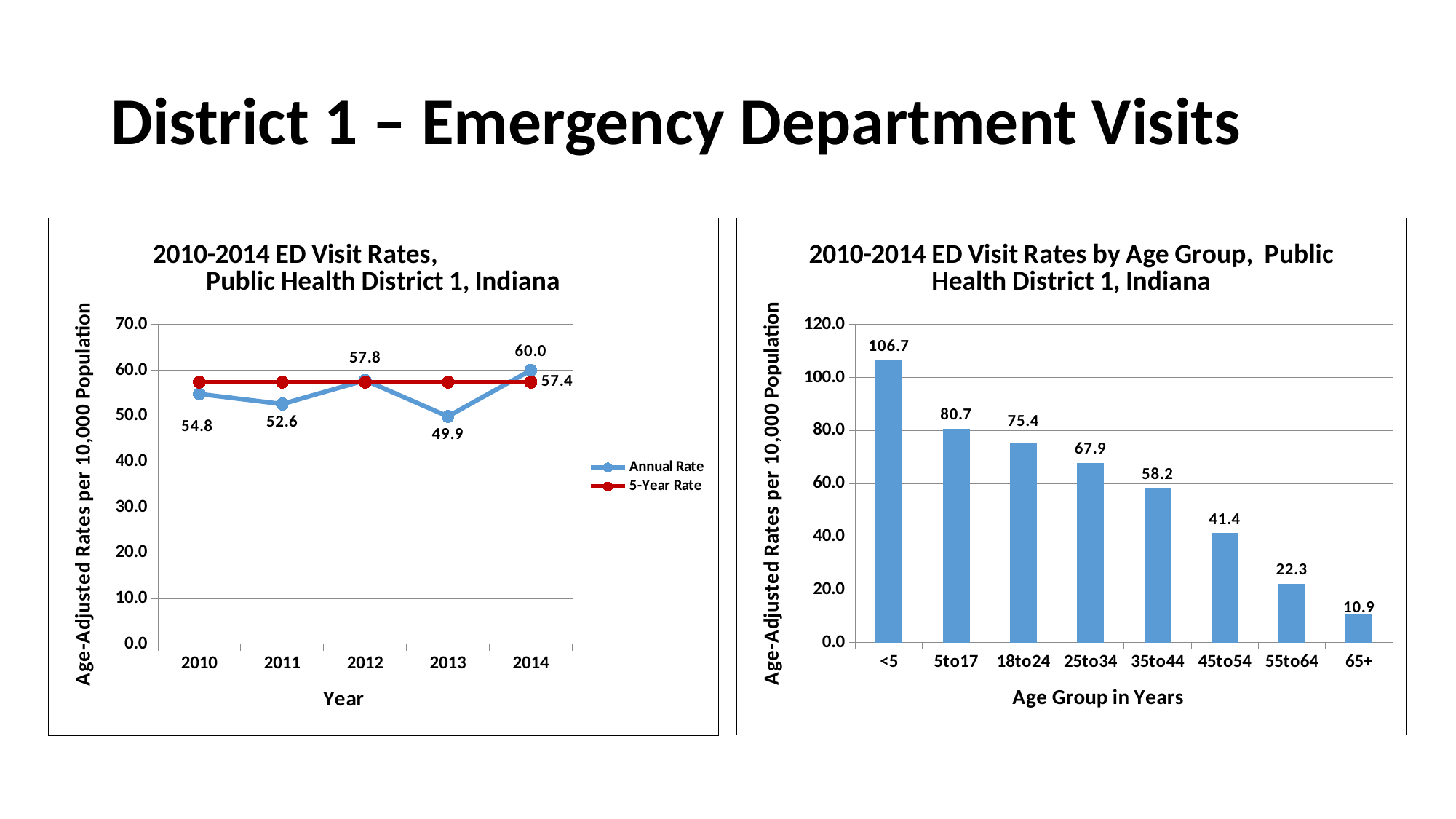
In the left chart (2010-2014 ED Visit Rates), what is the Annual Rate for 2013? 49.9 In the right chart (ED Visit Rates by Age Group), what is the difference between the rates for <5 and 65+? 95.8 In the left chart (2010-2014 ED Visit Rates), how many series does the legend list? 2 In the right chart (ED Visit Rates by Age Group), how many age groups are shown? 8 In the right chart (ED Visit Rates by Age Group), do the values rise or fall from left to right across the age groups? Fall In the right chart (ED Visit Rates by Age Group), which age group has the highest rate? <5 In the left chart (2010-2014 ED Visit Rates), what kind of chart is it? Line chart In the left chart (2010-2014 ED Visit Rates), what is the 5-Year Rate? 57.4 In the left chart (2010-2014 ED Visit Rates), which year has the highest Annual Rate? 2014 In the right chart (ED Visit Rates by Age Group), what is the value for the 25to34 age group? 67.9 In the left chart (2010-2014 ED Visit Rates), which year has the lowest Annual Rate? 2013 In the left chart (2010-2014 ED Visit Rates), what is the difference between the Annual Rate in 2014 and in 2013? 10.1